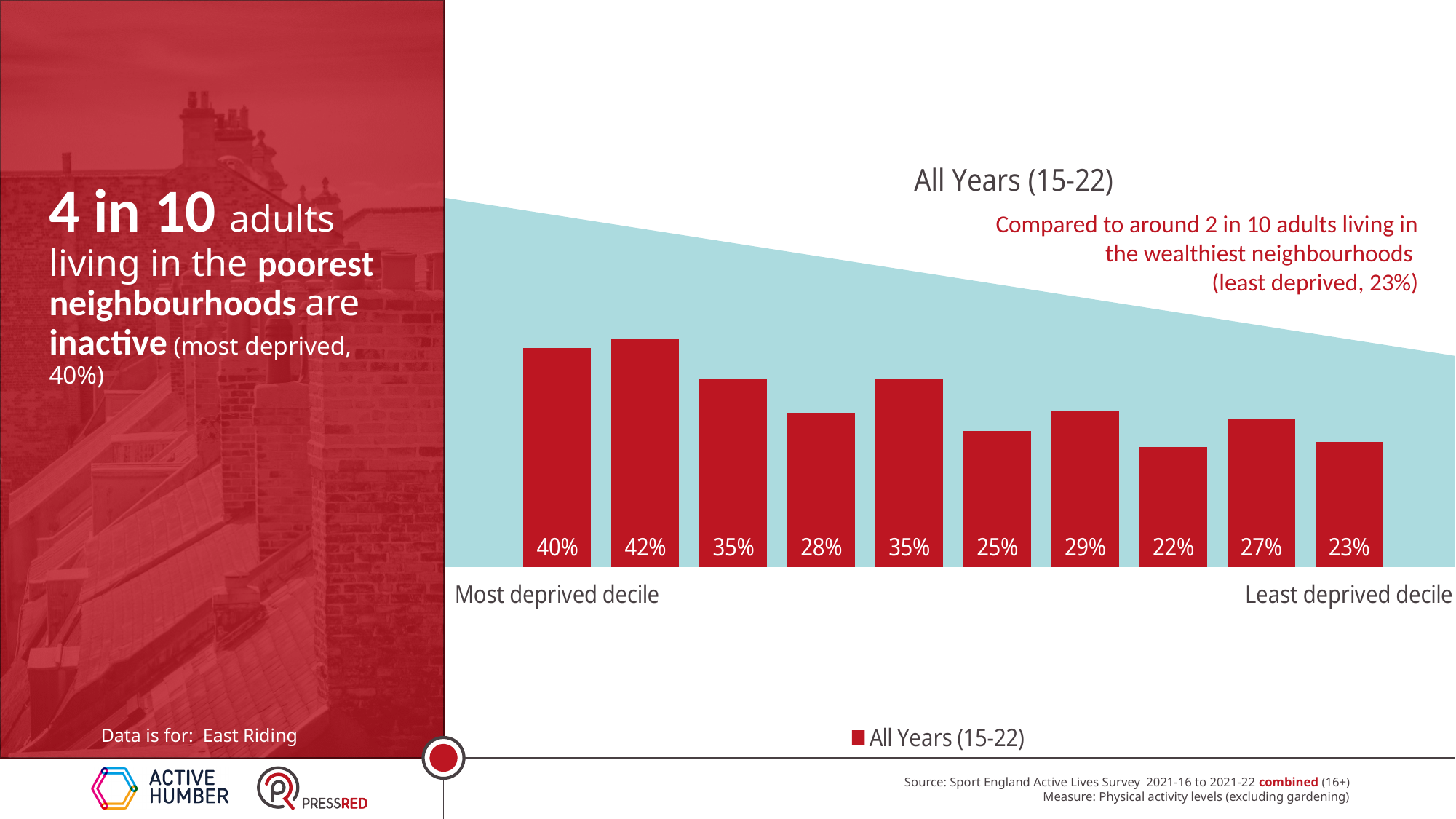
How many bars are plotted on the chart? 10 What kind of chart is shown on the slide? Bar chart How many series does the legend list? 1 What is the value of the second bar from the left? 42% What is the value for the most deprived decile (the first bar)? 40% What is the difference between the most deprived decile and the least deprived decile? 17 percentage points What is the title of the chart? All Years (15-22) What is the value for the least deprived decile (the last bar)? 23% Which is larger, the value for the most deprived decile or the value for the least deprived decile? Most deprived decile Do the values generally rise or fall from the most deprived decile to the least deprived decile? Fall What is the lowest value shown on the chart? 22% Which bar has the highest value? The second bar from the left (42%)